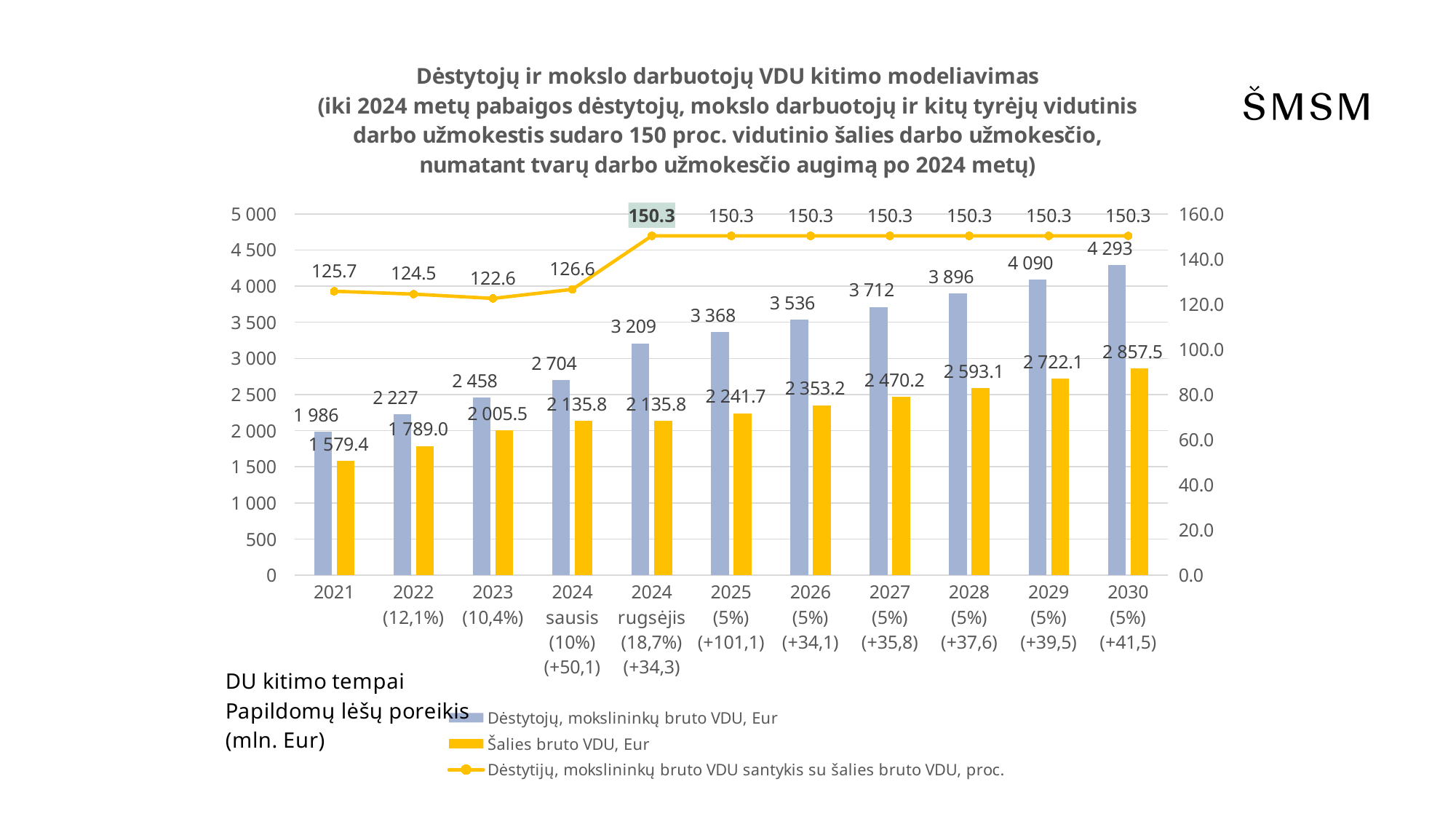
What is the value of 'Dėstytojų, mokslininkų bruto VDU, Eur' for 2021? 1 986 What kind of chart is this? Combined bar and line chart Do the values of 'Šalies bruto VDU, Eur' rise or fall from 2021 to 2030? Rise What is the difference between 'Dėstytojų, mokslininkų bruto VDU, Eur' and 'Šalies bruto VDU, Eur' in 2025? 1 126.3 How many categories are shown on the x axis? 11 Which category has the lowest value for the ratio line ('Dėstytijų, mokslininkų bruto VDU santykis su šalies bruto VDU, proc.')? 2023 What is the value of the ratio line ('Dėstytijų, mokslininkų bruto VDU santykis su šalies bruto VDU, proc.') for 2023? 122.6 Which is larger in 2022: 'Dėstytojų, mokslininkų bruto VDU, Eur' or 'Šalies bruto VDU, Eur'? Dėstytojų, mokslininkų bruto VDU, Eur What is the value of 'Dėstytojų, mokslininkų bruto VDU, Eur' for 2024 rugsėjis? 3 209 How many series does the legend list? 3 What is the value of 'Šalies bruto VDU, Eur' for 2030? 2 857.5 Which category has the highest value for 'Dėstytojų, mokslininkų bruto VDU, Eur'? 2030